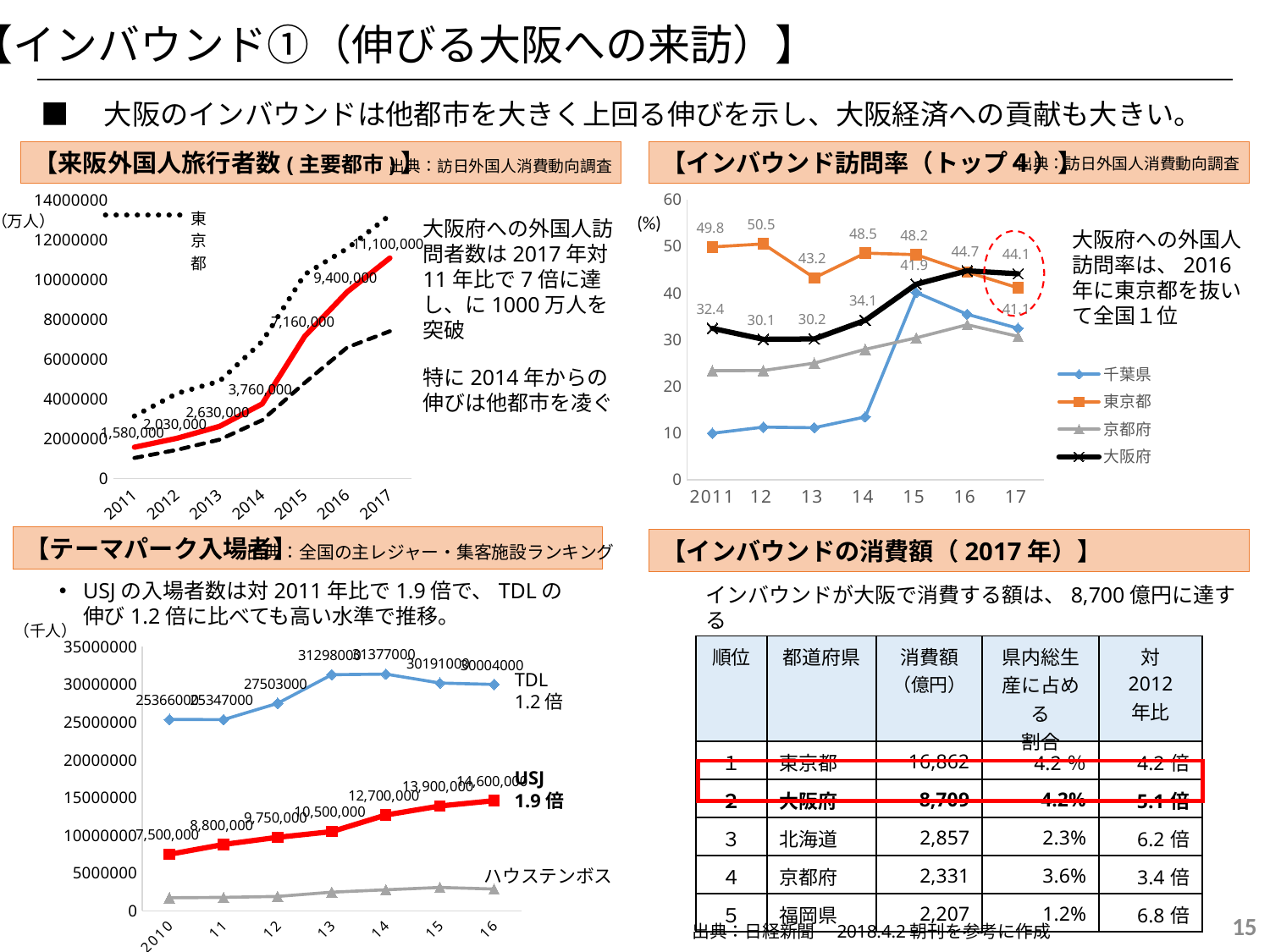
In the 来阪外国人旅行者数 chart (top left), how many years are shown on the x axis? 7 In the 来阪外国人旅行者数 chart (top left), what is the value of the red line for 2014? 3,760,000 In the インバウンド訪問率 chart (top right), which series has the lowest value in 2011? 千葉県 In the テーマパーク入場者数 chart (bottom left), which series has the highest value in 2014? TDL In the インバウンド訪問率 chart (top right), what is the value for 東京都 in 2011? 49.8 In the インバウンド訪問率 chart (top right), how many series does the legend list? 4 In the 来阪外国人旅行者数 chart (top left), what is the value of the red line for 2017? 11,100,000 In the インバウンド訪問率 chart (top right), what is the value for 大阪府 in 2017? 44.1 In the 来阪外国人旅行者数 chart (top left), what is the difference between the red line's 2017 value and its 2011 value? 9,520,000 In the インバウンド訪問率 chart (top right), is the value for 京都府 in 2011 greater or less than 30? less What kind of chart is the テーマパーク入場者数 chart (bottom left)? line chart In the テーマパーク入場者数 chart (bottom left), what is the value for USJ in 2016? 14,600,000